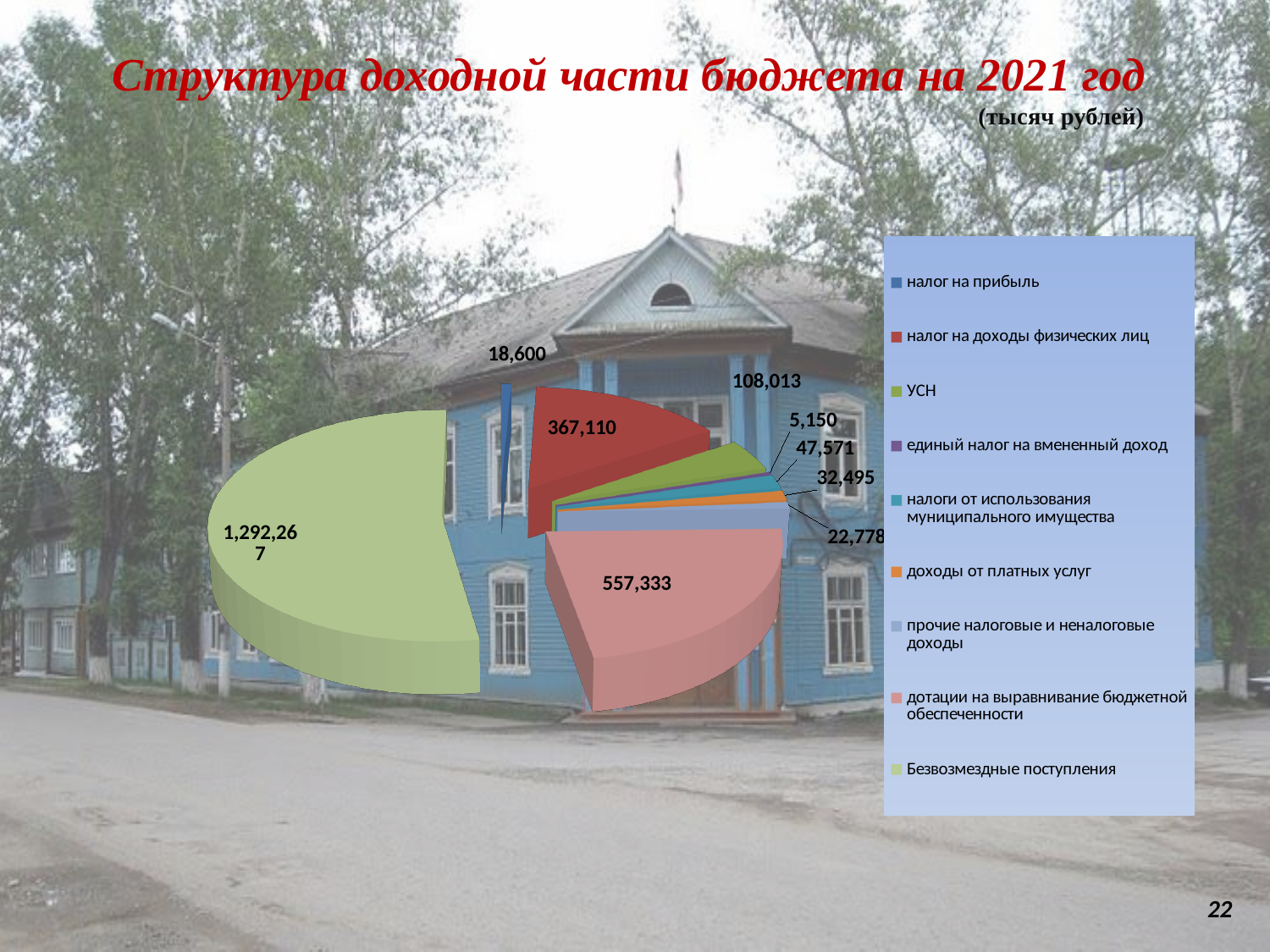
What is the title of the chart on the slide? Структура доходной части бюджета на 2021 год Which category has the largest slice of the pie? Безвозмездные поступления What is the value for дотации на выравнивание бюджетной обеспеченности? 557,333 What is the value for УСН? 108,013 How many categories does the legend of the pie chart list? 9 Which category has the smallest slice of the pie? единый налог на вмененный доход What is the value for единый налог на вмененный доход? 5,150 What kind of chart is shown on the slide? pie chart What is the value for налог на прибыль? 18,600 What is the value for налог на доходы физических лиц? 367,110 What is the difference between the values for налоги от использования муниципального имущества and доходы от платных услуг? 15,076 Which is larger: the value for налог на доходы физических лиц or the value for дотации на выравнивание бюджетной обеспеченности? дотации на выравнивание бюджетной обеспеченности